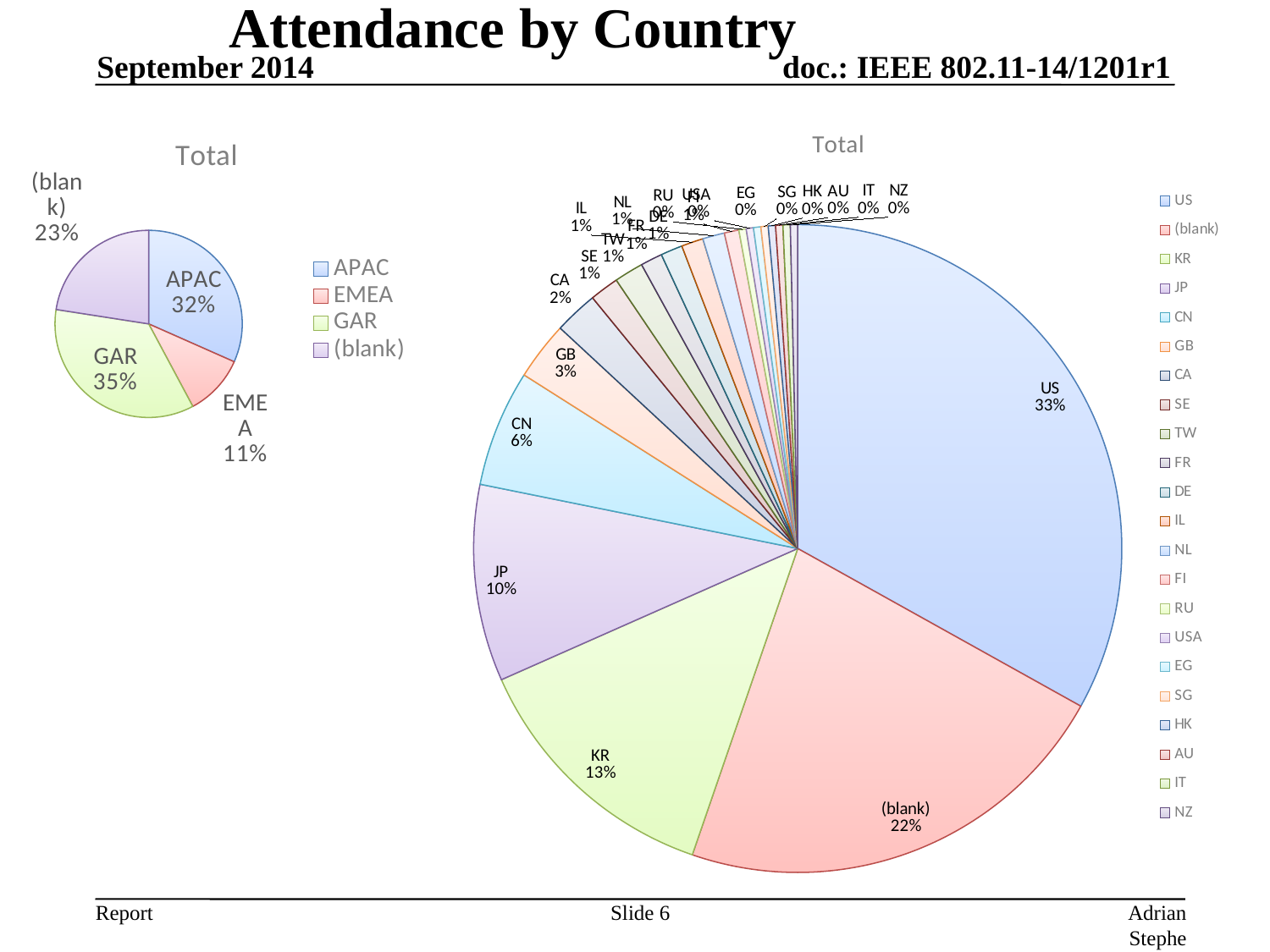
In the left pie chart, how many categories does the legend list? 4 In the right pie chart, which category has the largest slice? US In the right pie chart, what share does KR have? 13% In the left pie chart, which category has the largest slice? GAR In the left pie chart, what share does EMEA have? 11% In the right pie chart, what share does US have? 33% In the right pie chart, which is larger, JP or CN? JP What type of chart is shown on the right of the slide? Pie chart In the left pie chart, which category has the smallest slice? EMEA In the left pie chart, what is the difference in percentage points between GAR and APAC? 3 In the right pie chart, what is the difference in percentage points between US and (blank)? 11